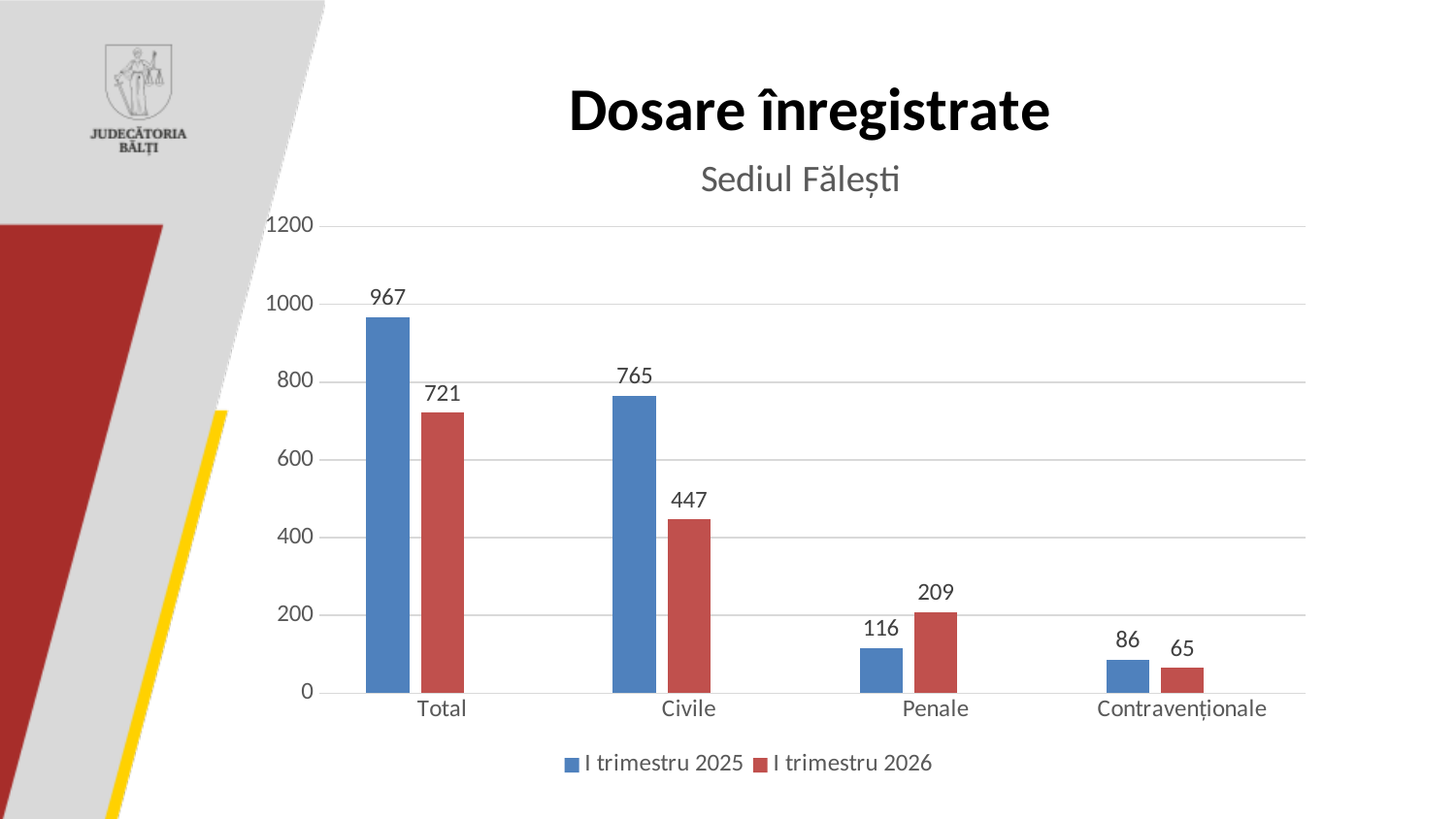
What kind of chart is shown on the slide? Bar chart How many categories are shown on the x axis? 4 Is the value for Civile in I trimestru 2026 greater or less than 400? greater What is the value for Penale in the I trimestru 2026 series? 209 What is the value for Contravenționale in the I trimestru 2025 series? 86 How many series does the legend list? 2 Which category has the highest value in the I trimestru 2025 series? Total For Penale, which series has the larger value, I trimestru 2025 or I trimestru 2026? I trimestru 2026 What is the value for Civile in the I trimestru 2025 series? 765 What is the difference between the Civile values for I trimestru 2025 and I trimestru 2026? 318 What is the difference between the Total values for I trimestru 2025 and I trimestru 2026? 246 Which category has the lowest value in the I trimestru 2026 series? Contravenționale